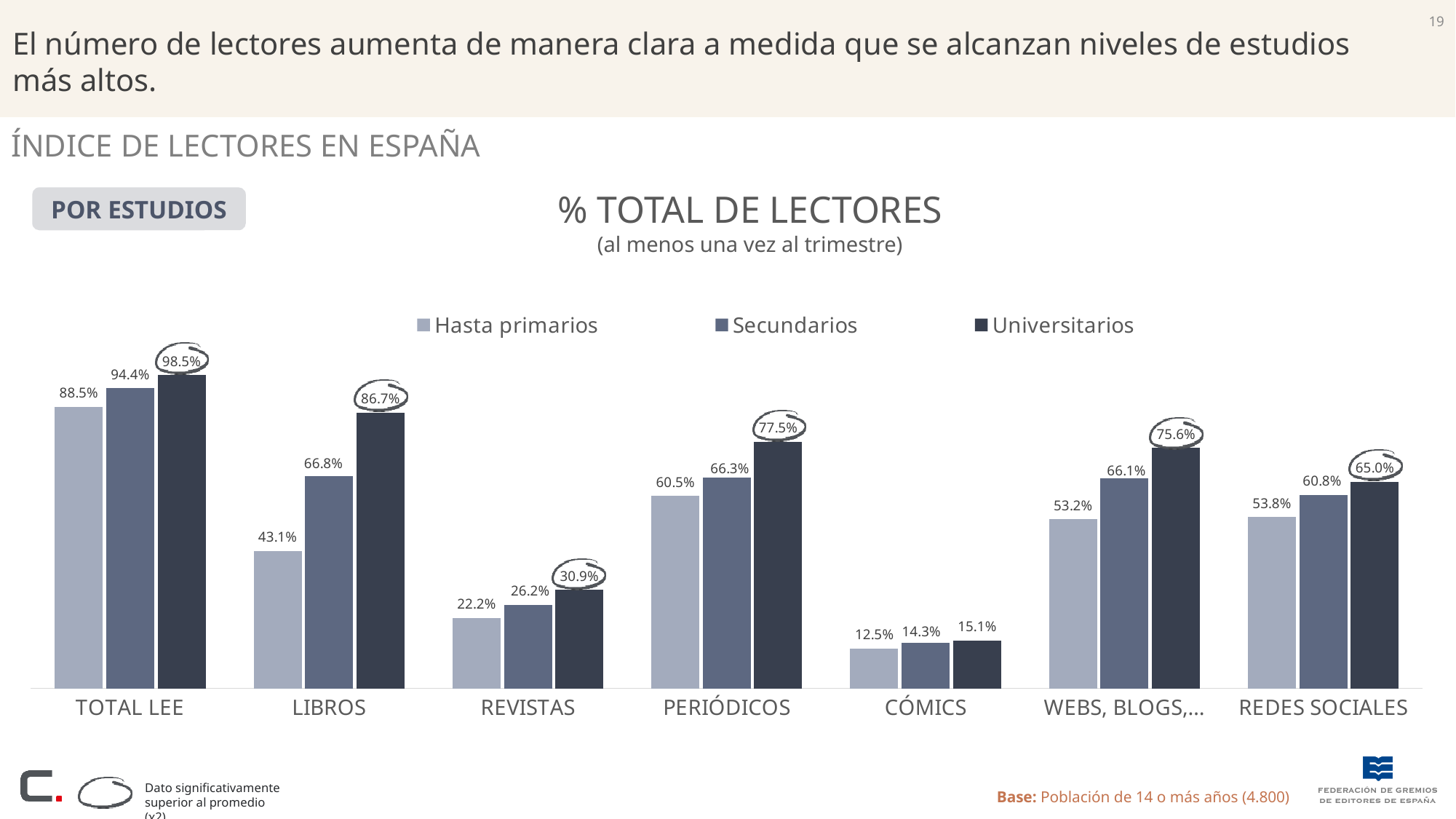
Which category has the highest value for Universitarios? TOTAL LEE What is the value for Secundarios in the REDES SOCIALES category? 60.8% What is the title of the chart? % TOTAL DE LECTORES What is the value for Universitarios in the LIBROS category? 86.7% Which is larger in the WEBS, BLOGS,... category: Secundarios or Hasta primarios? Secundarios What is the value for Hasta primarios in the PERIÓDICOS category? 60.5% What is the difference between the Universitarios and Hasta primarios values in the LIBROS category? 43.6% How many categories are shown on the x axis? 7 What is the difference between the Secundarios and Hasta primarios values in the REVISTAS category? 4.0% How many series does the legend list? 3 Which category has the lowest value for Hasta primarios? CÓMICS What kind of chart is shown on the slide? Bar chart